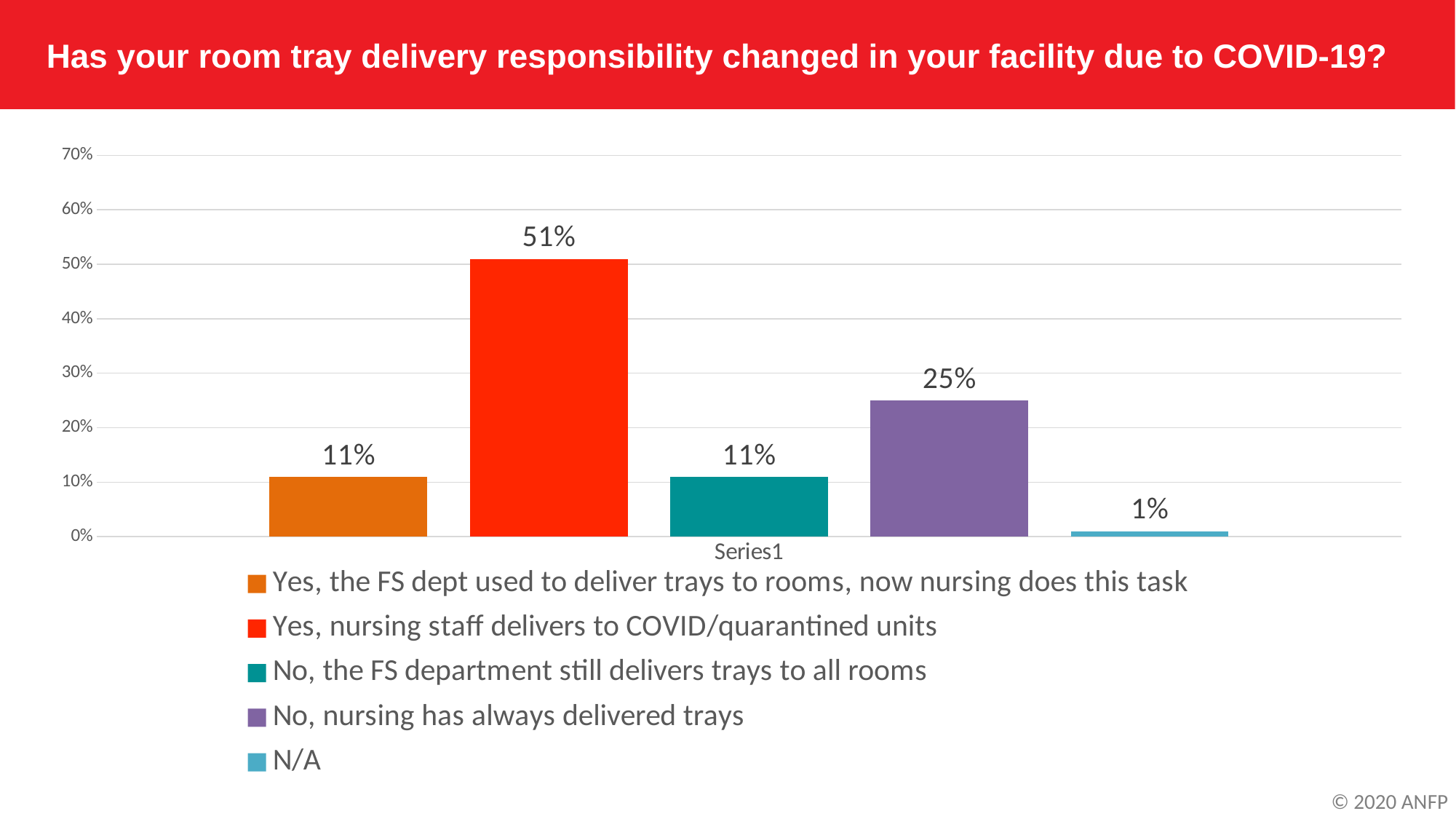
Is the value for 'Yes, nursing staff delivers to COVID/quarantined units' greater or less than 40%? greater How many response categories are shown in the chart? 5 Which response has the highest percentage? Yes, nursing staff delivers to COVID/quarantined units What percentage of respondents said nursing staff delivers to COVID/quarantined units? 51% Which response has the lowest percentage? N/A What colour is the bar for 'No, nursing has always delivered trays'? Purple What percentage of respondents answered N/A? 1% Which is larger: the percentage for 'No, nursing has always delivered trays' or for 'Yes, the FS dept used to deliver trays to rooms, now nursing does this task'? No, nursing has always delivered trays What is the difference in percentage points between 'Yes, nursing staff delivers to COVID/quarantined units' and 'No, nursing has always delivered trays'? 26 What type of chart is shown on the slide? Bar chart What percentage of respondents said the FS department still delivers trays to all rooms? 11% What percentage of respondents said nursing has always delivered trays? 25%